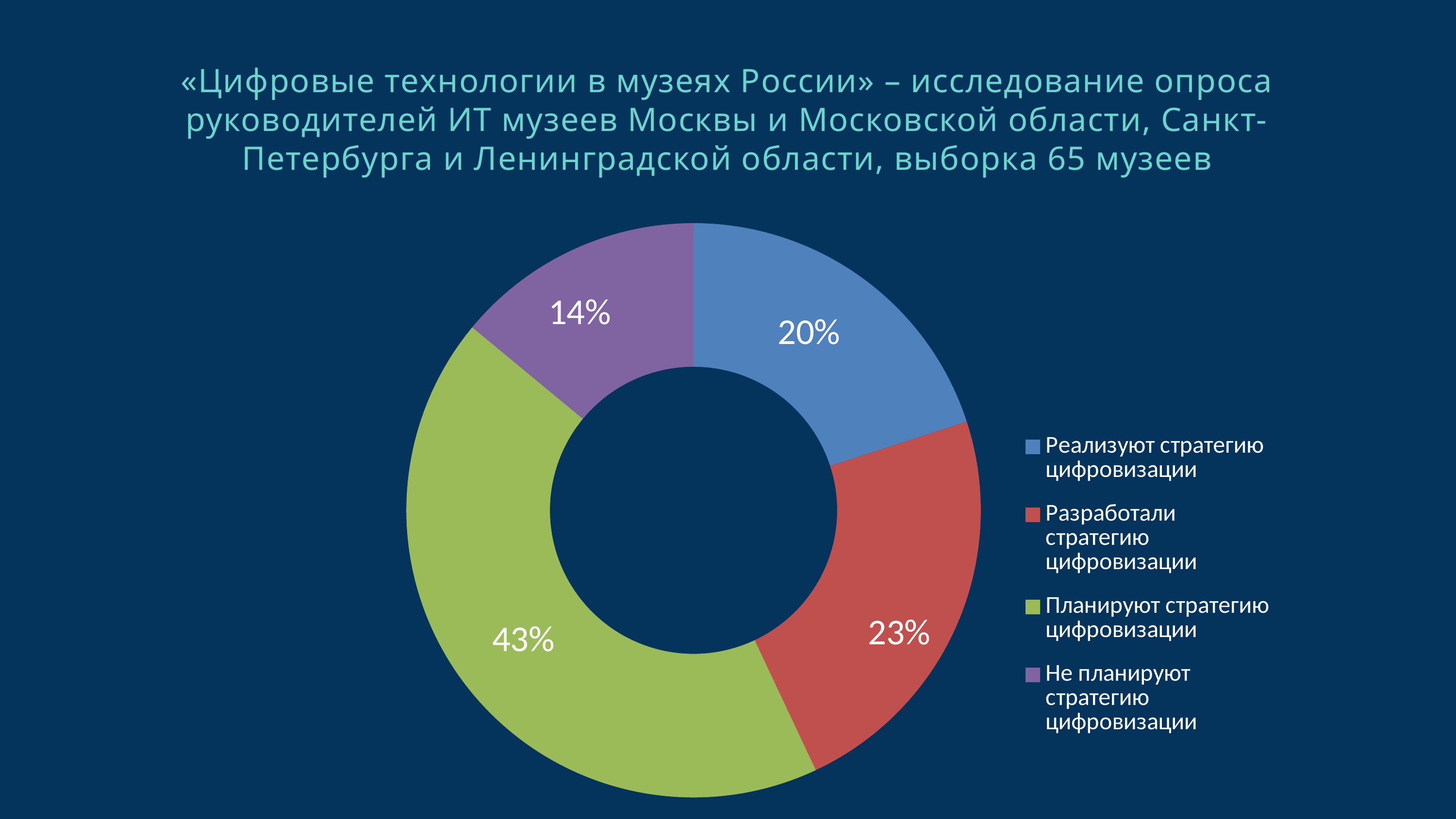
Which category has the largest share of the chart? Планируют стратегию цифровизации What colour is the slice for museums that do not plan a digitalisation strategy? Purple What is the difference in percentage points between the share planning a strategy and the share not planning one? 29 What share of museums are planning a digitalisation strategy (Планируют стратегию цифровизации)? 43% How many museums were in the survey sample according to the title? 65 What share of museums do not plan a digitalisation strategy (Не планируют стратегию цифровизации)? 14% How many categories does the chart show? 4 What share of museums have developed a digitalisation strategy (Разработали стратегию цифровизации)? 23% Which is larger: the share that have developed a strategy or the share that are implementing one? Разработали стратегию цифровизации What kind of chart is shown on the slide? Doughnut (pie) chart What share of museums are implementing a digitalisation strategy (Реализуют стратегию цифровизации)? 20% Which category has the smallest share of the chart? Не планируют стратегию цифровизации